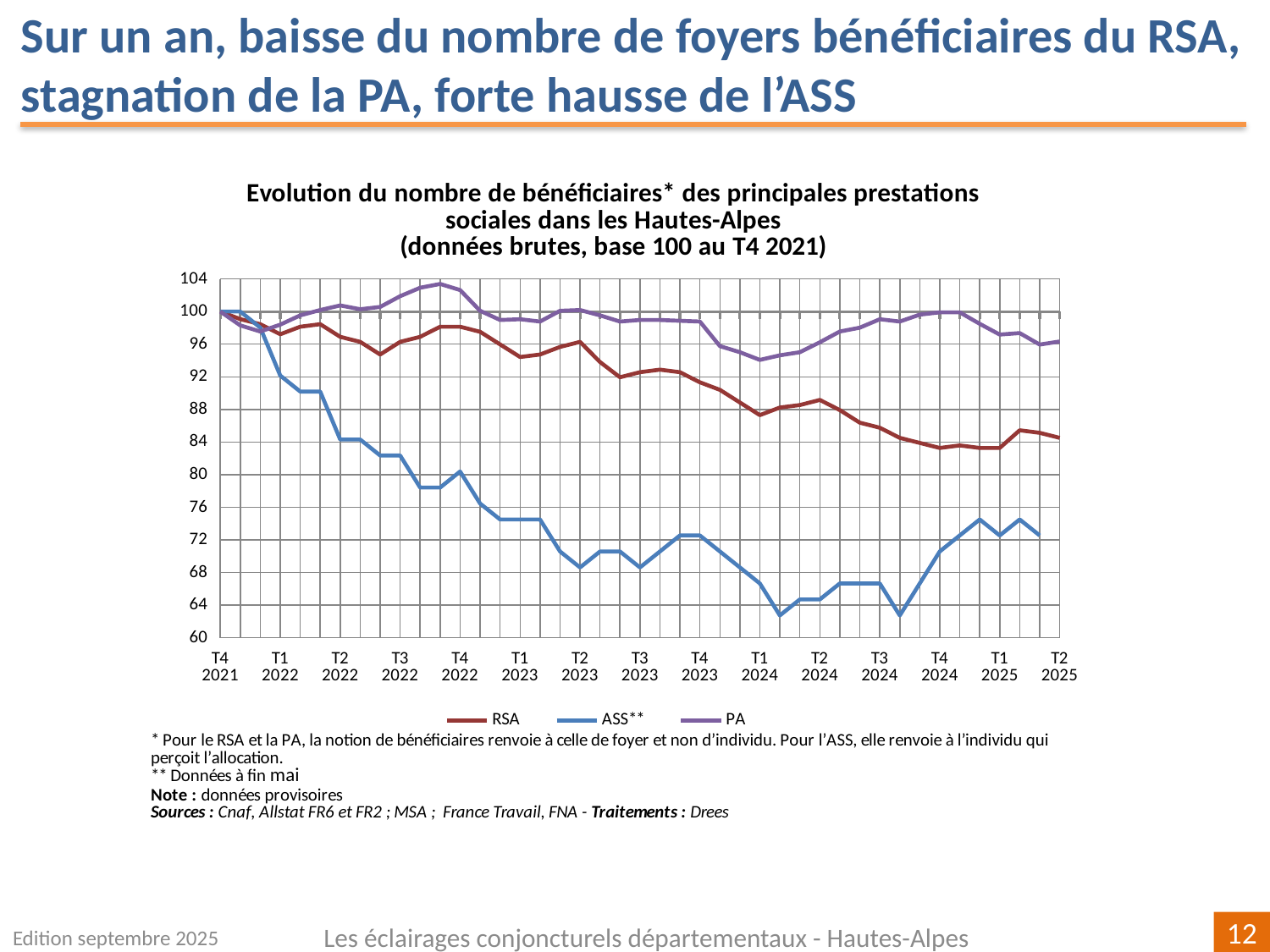
Is the value of the ASS** series at T4 2022 greater or less than 76? greater How many series does the legend list? 3 What colour is the line for the PA series? purple What is the value of the RSA series at T4 2021? 100 Is the value of the PA series at T4 2022 greater or less than 100? greater Is the value of the PA series at T1 2024 greater or less than 96? less Does the ASS** series rise or fall between T4 2021 and T1 2024? fall What type of chart is shown on the slide? line chart